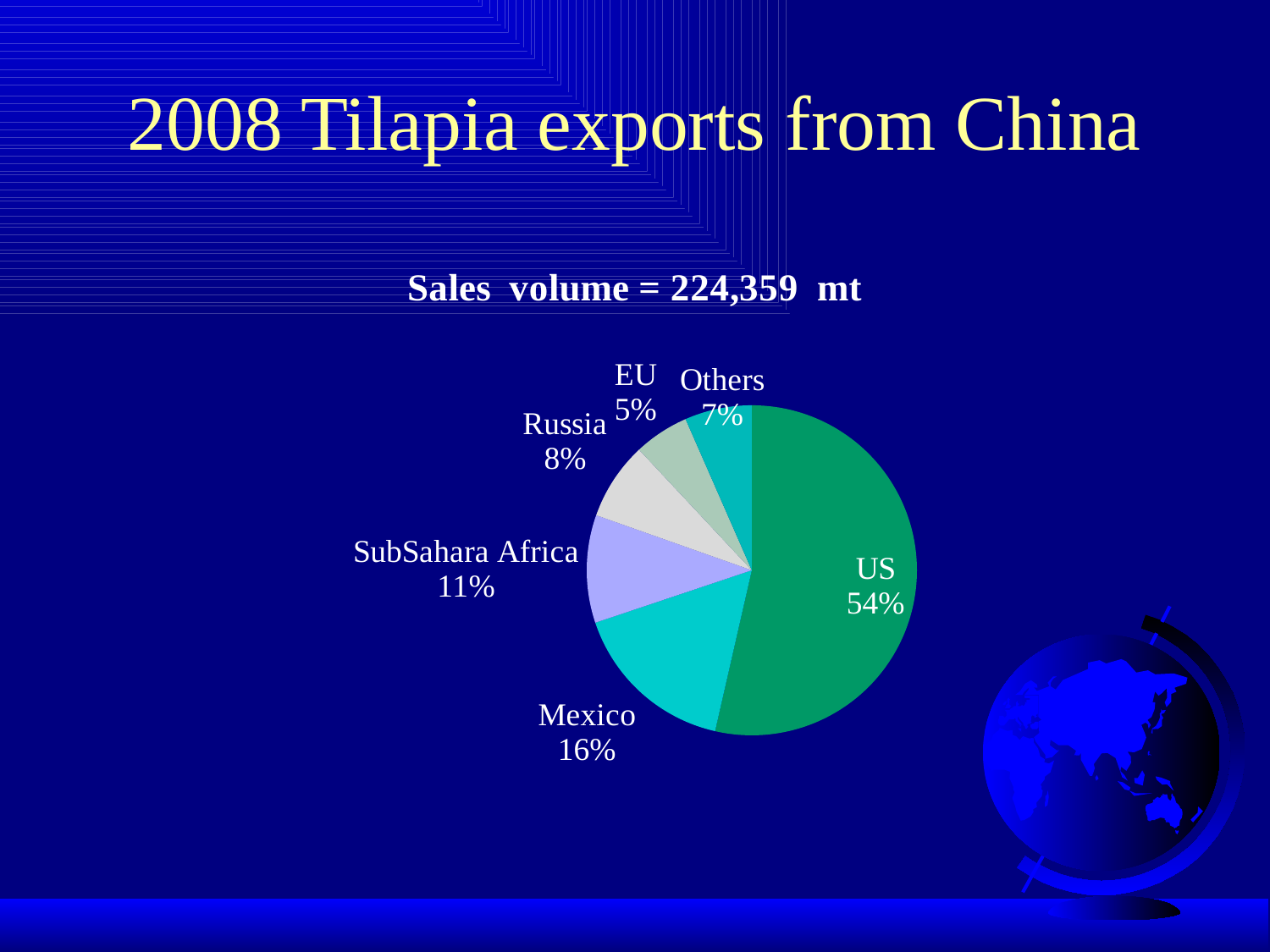
What sales volume is stated above the chart? 224,359 mt What share of the exports went to Mexico? 16% What share of the exports went to Russia? 8% What kind of chart is shown on the slide? pie chart What share of the exports went to the EU? 5% Which is larger, the share for Russia or the share for Others? Russia What is the difference in percentage points between the US share and the Mexico share? 38 Which destination has the smallest slice of the pie? EU How many slices does the pie chart have? 6 Which destination has the largest slice of the pie? US